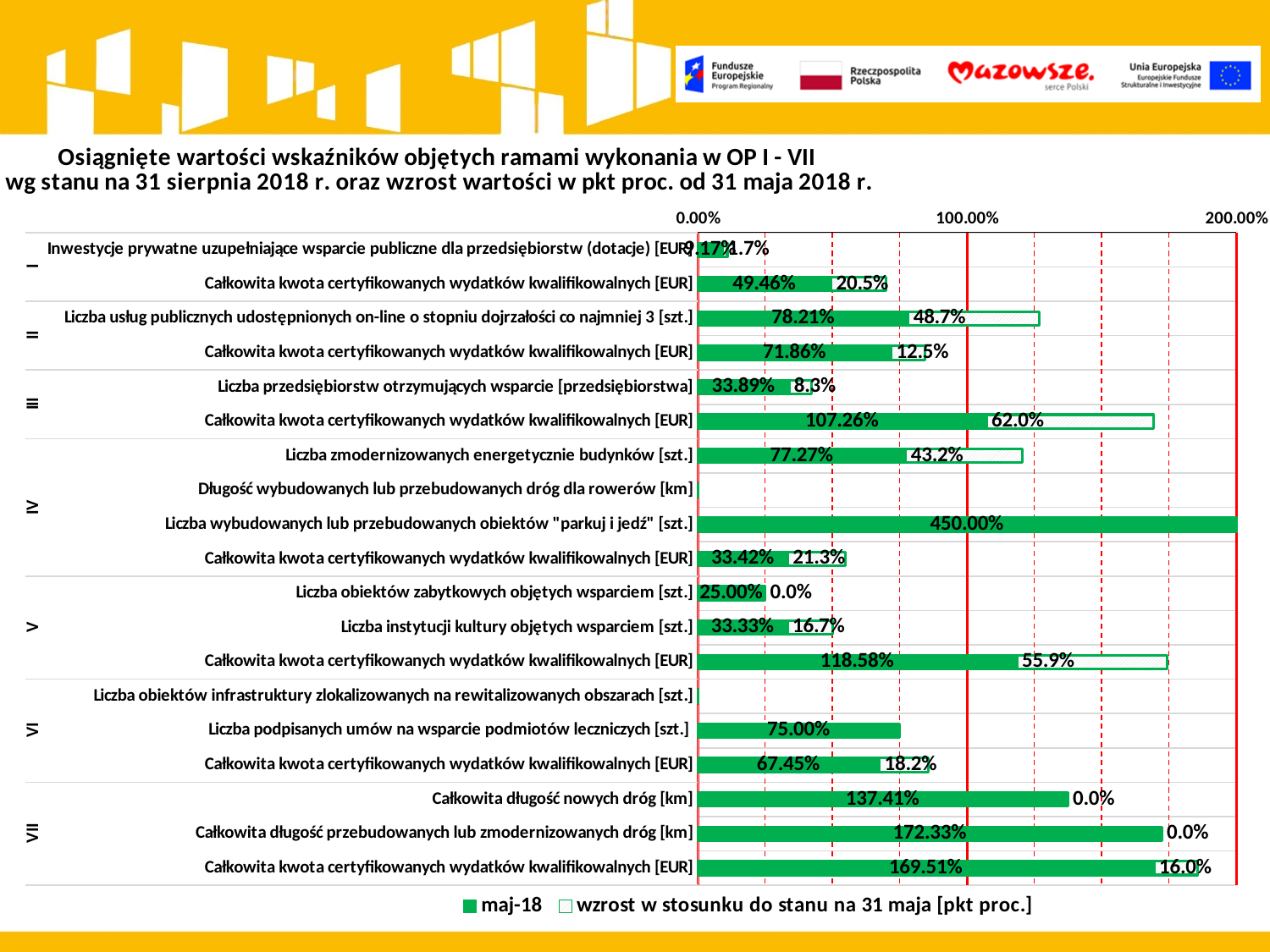
Which indicator has the highest "wzrost w stosunku do stanu na 31 maja [pkt proc.]" value? Całkowita kwota certyfikowanych wydatków kwalifikowalnych [EUR] in OP III (62.0%) What is the "wzrost w stosunku do stanu na 31 maja [pkt proc.]" value for "Liczba usług publicznych udostępnionych on-line o stopniu dojrzałości co najmniej 3 [szt.]"? 48.7% Which indicator has the highest maj-18 value? Liczba wybudowanych lub przebudowanych obiektów "parkuj i jedź" [szt.] What is the difference between the maj-18 values for "Całkowita kwota certyfikowanych wydatków kwalifikowalnych [EUR]" in OP V and in OP III? 11.32 percentage points What is the maj-18 value for "Liczba wybudowanych lub przebudowanych obiektów "parkuj i jedź" [szt.]"? 450.00% What is the "wzrost w stosunku do stanu na 31 maja [pkt proc.]" value for "Całkowita kwota certyfikowanych wydatków kwalifikowalnych [EUR]" in OP III? 62.0% Which has a larger maj-18 value: "Całkowita długość nowych dróg [km]" or "Całkowita kwota certyfikowanych wydatków kwalifikowalnych [EUR]" in OP V? Całkowita długość nowych dróg [km] What kind of chart is shown on the slide? Bar chart How many series does the legend list? 2 What are the two legend entries of the chart? maj-18; wzrost w stosunku do stanu na 31 maja [pkt proc.] Is the maj-18 value for "Całkowita kwota certyfikowanych wydatków kwalifikowalnych [EUR]" in OP III greater or less than 100.00%? greater What is the maj-18 value for "Całkowita długość przebudowanych lub zmodernizowanych dróg [km]"? 172.33%